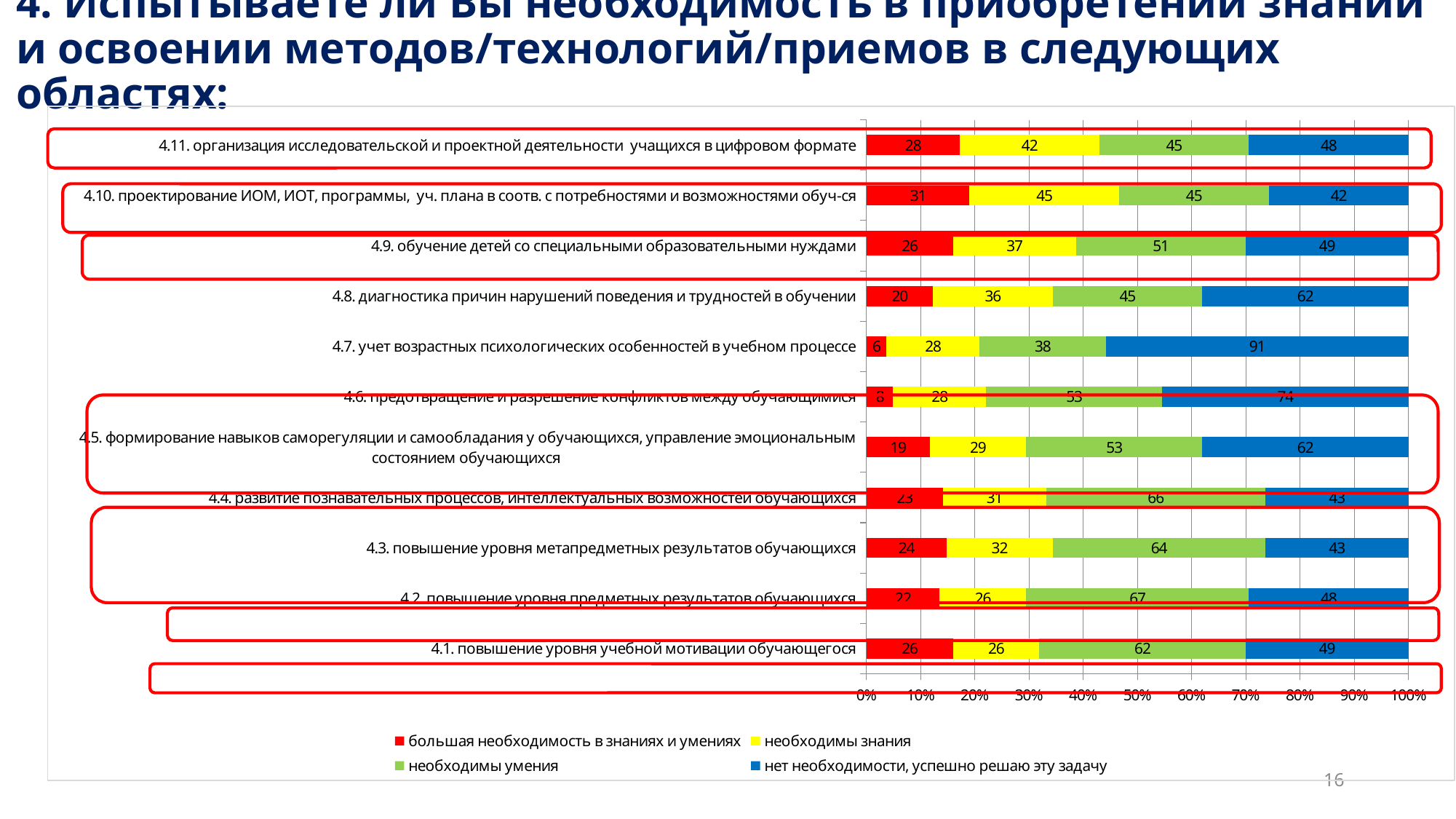
What kind of chart is shown on the slide? stacked bar chart What is the value of the 'нет необходимости, успешно решаю эту задачу' series for '4.7. учет возрастных психологических особенностей в учебном процессе'? 91 How many series does the legend list? 4 How many categories (areas) are plotted in the chart? 11 Which colour represents the 'необходимы знания' series in the chart? yellow Which category has the lowest value in the 'большая необходимость в знаниях и умениях' series? 4.7. учет возрастных психологических особенностей в учебном процессе What is the value of the 'необходимы умения' series for '4.3. повышение уровня метапредметных результатов обучающихся'? 64 Which is larger: the 'необходимы знания' value for '4.11. организация исследовательской и проектной деятельности учащихся в цифровом формате' or for '4.1. повышение уровня учебной мотивации обучающегося'? 4.11. организация исследовательской и проектной деятельности учащихся в цифровом формате What is the total of all four series for '4.11. организация исследовательской и проектной деятельности учащихся в цифровом формате'? 163 What is the difference between the 'необходимы умения' value for '4.9. обучение детей со специальными образовательными нуждами' (51) and for '4.8. диагностика причин нарушений поведения и трудностей в обучении' (45)? 6 Which category has the highest value in the 'нет необходимости, успешно решаю эту задачу' series? 4.7. учет возрастных психологических особенностей в учебном процессе What is the value of the 'большая необходимость в знаниях и умениях' series for '4.10. проектирование ИОМ, ИОТ, программы, уч. плана в соотв. с потребностями и возможностями обуч-ся'? 31